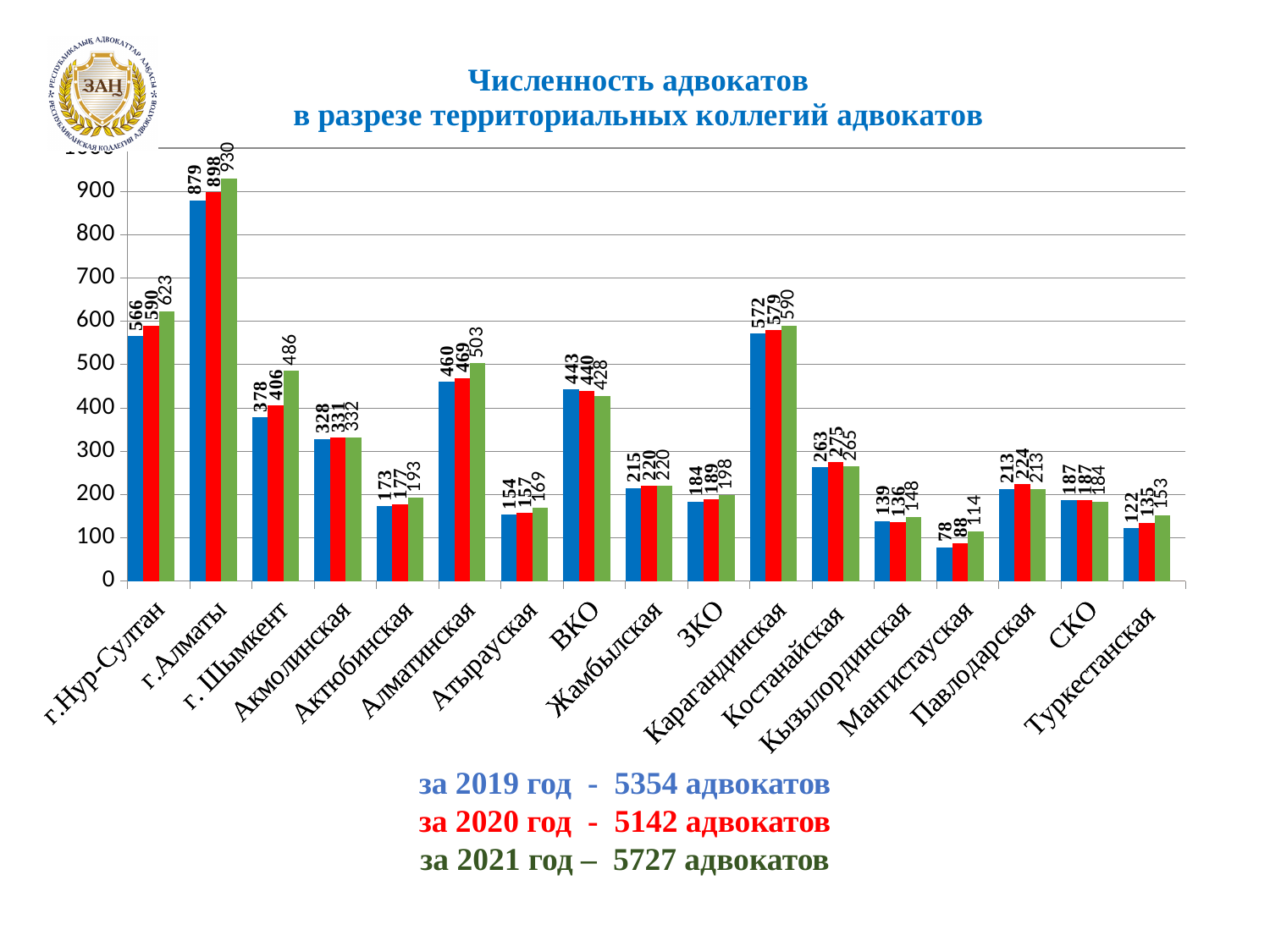
Do the values for Мангистауская rise or fall from the blue (2019) bar to the green (2021) bar? rise Which is larger for ВКО: the blue (2019) bar or the green (2021) bar? the blue (2019) bar Which category has the highest bars in the chart? г.Алматы How many territorial collegiums (categories) are shown on the x axis of the chart? 17 According to the text below the chart, what was the total number of advocates in 2021? 5727 What is the value of the red (2020) bar for г. Шымкент? 406 Which category has the lowest blue (2019) bar in the chart? Мангистауская What is the value of the blue (2019) bar for Мангистауская? 78 What is the difference between the green (2021) and blue (2019) bars for г. Шымкент? 108 What is the difference between the green (2021) bars for Карагандинская and г.Нур-Султан? 33 What is the value of the green (2021) bar for г.Алматы? 930 What type of chart is shown on the slide? bar chart